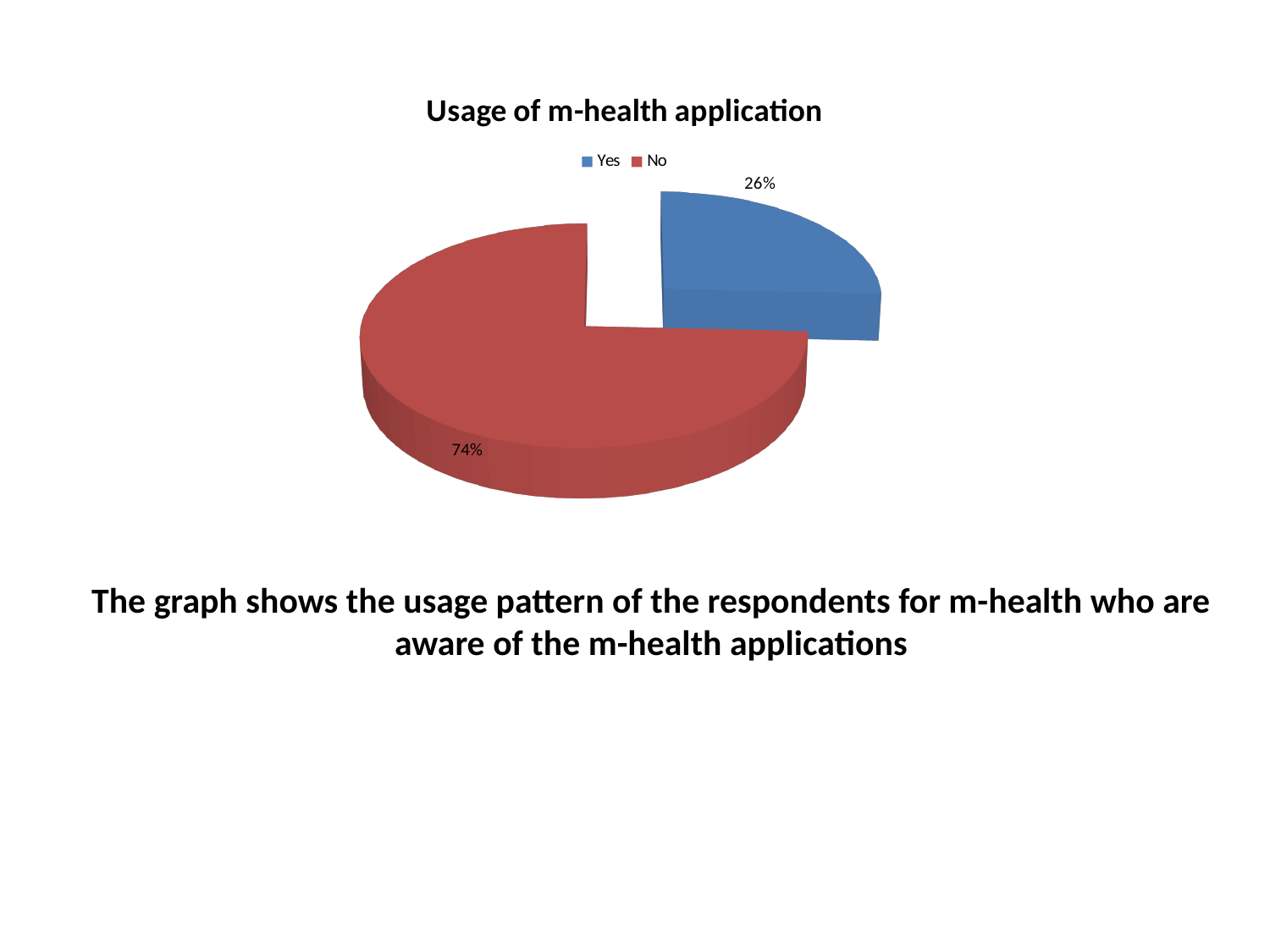
Which category has the smallest share of the pie? Yes What kind of chart is shown on the slide? Pie chart How many categories does the legend list? 2 What colour is the slice for No? Red What is the difference in percentage points between the No and Yes shares? 48 Which is larger, the share for Yes or the share for No? No How many slices does the pie chart have? 2 What percentage of respondents answered No? 74% Which category has the largest share of the pie? No What is the title of the chart? Usage of m-health application What percentage of respondents answered Yes? 26% What share of the pie does the Yes slice represent? 26%